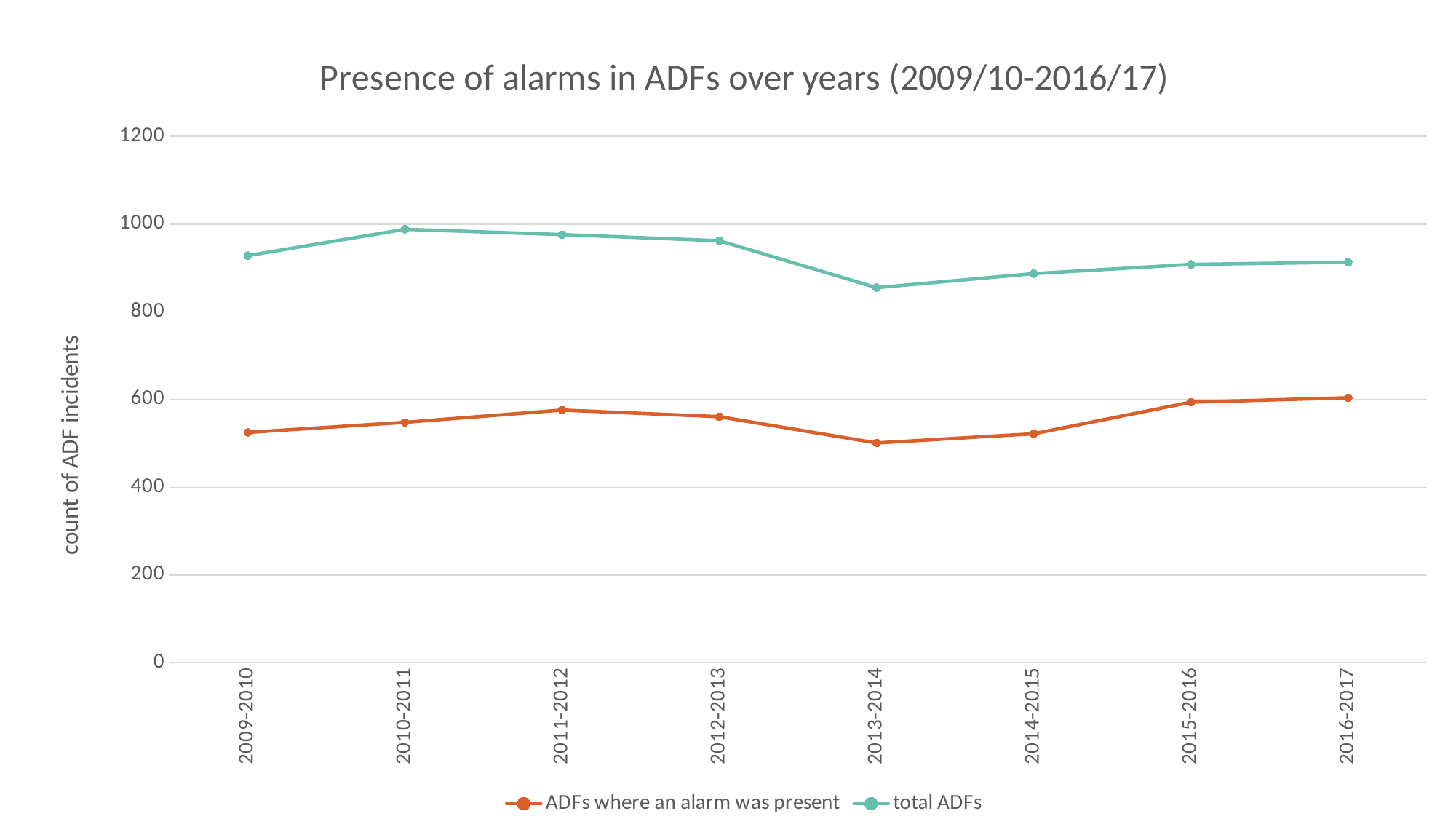
In which year period is the value for ADFs where an alarm was present lowest? 2013-2014 Is the value for total ADFs in 2013-2014 greater or less than 800? greater How many series does the legend list? 2 What kind of chart is shown on the slide? line chart Which is larger for ADFs where an alarm was present: 2011-2012 or 2013-2014? 2011-2012 Is the value for ADFs where an alarm was present in 2013-2014 greater or less than 600? less Which is larger in 2012-2013: total ADFs or ADFs where an alarm was present? total ADFs In which year period is the value for total ADFs lowest? 2013-2014 How many year periods are plotted along the x axis? 8 Is the value for total ADFs in 2010-2011 greater or less than 1000? less Does the value for total ADFs rise or fall from 2012-2013 to 2013-2014? fall What is the label on the y axis? count of ADF incidents